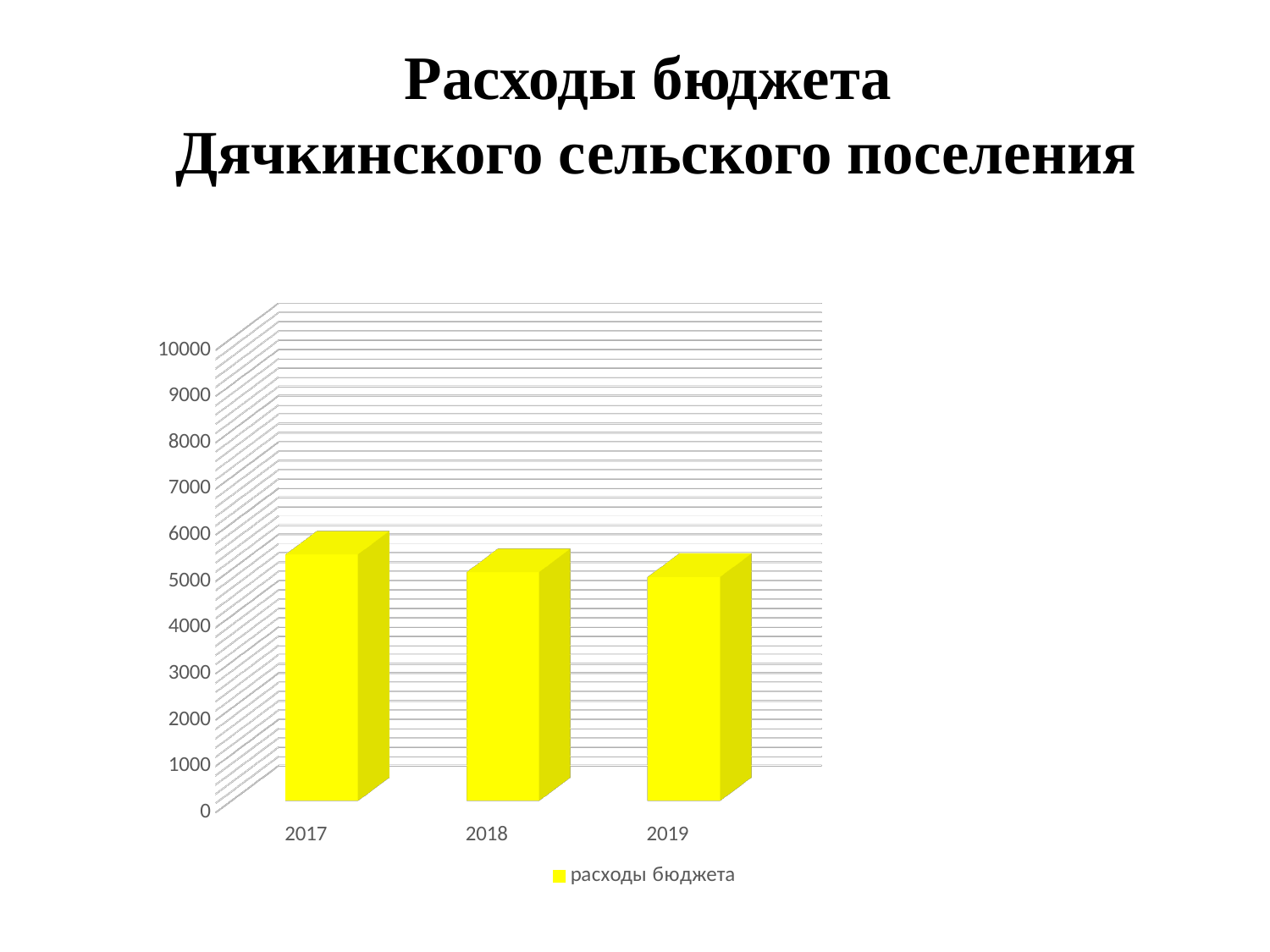
Is the value for 2019 greater or less than 4000? greater Is the value for 2018 greater or less than 6000? less How many years are shown on the x axis of the chart? 3 Which year has the highest budget expenditure in the chart? 2017 What is the name of the series shown in the chart legend? расходы бюджета Is the value for 2017 greater or less than 6000? less What kind of chart is shown on the slide? bar chart Which is larger, the value for 2017 or the value for 2019? 2017 What colour are the bars in the chart? yellow How many series does the chart legend list? 1 Do the values rise or fall from 2017 to 2019? fall